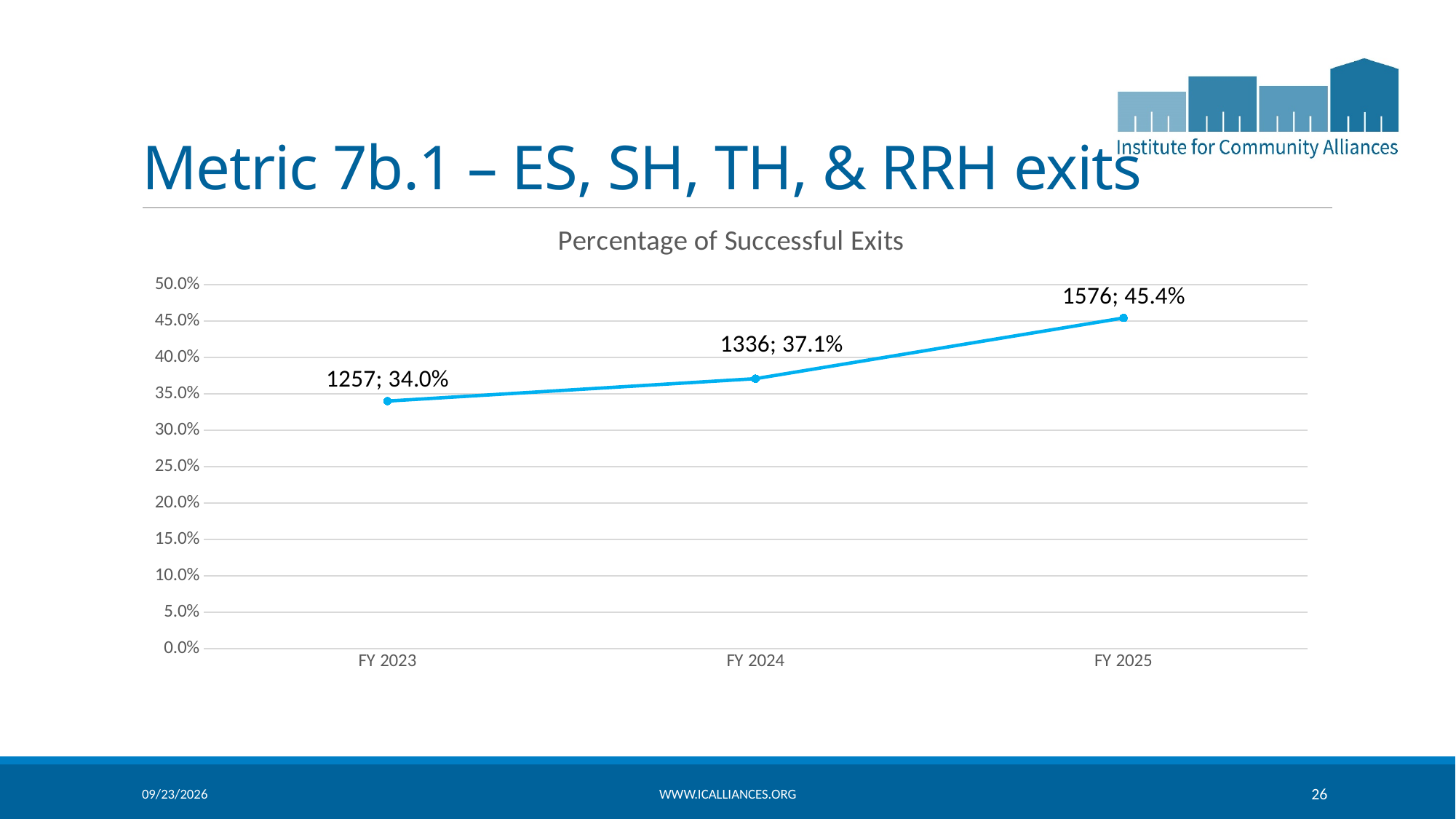
What is the percentage of successful exits for FY 2023? 34.0% What kind of chart is shown on the slide? Line chart What is the percentage of successful exits for FY 2025? 45.4% Which is larger, the percentage for FY 2024 or FY 2023? FY 2024 Which fiscal year has the lowest percentage of successful exits? FY 2023 Which fiscal year has the highest percentage of successful exits? FY 2025 What count is shown in the data label for FY 2023? 1257 Does the percentage of successful exits rise or fall from FY 2023 to FY 2025? Rise What is the difference in percentage points between FY 2025 and FY 2024? 8.3 What is the percentage of successful exits for FY 2024? 37.1% What count is shown in the data label for FY 2025? 1576 How many fiscal years are plotted on the chart? 3